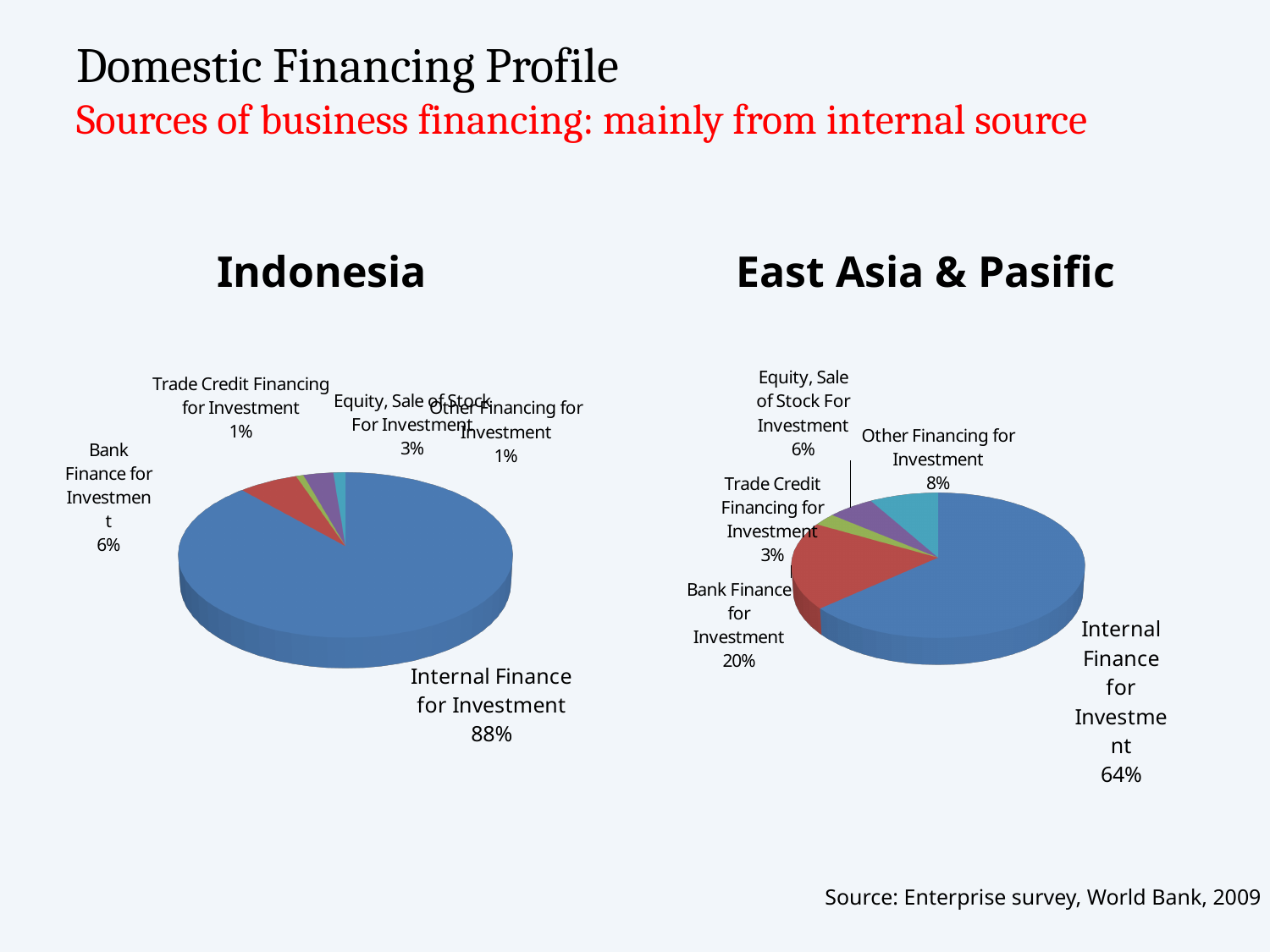
In the East Asia & Pasific chart, what share does Other Financing for Investment have? 8% In the East Asia & Pasific chart, what is the difference between Bank Finance for Investment and Equity, Sale of Stock For Investment? 14 percentage points What is the difference between the Internal Finance for Investment share in the Indonesia chart and in the East Asia & Pasific chart? 24 percentage points In the Indonesia chart, what share does Bank Finance for Investment have? 6% In the Indonesia chart, which category has the largest share? Internal Finance for Investment In the Indonesia chart, what share does Internal Finance for Investment have? 88% What kind of chart is the Indonesia chart? Pie chart How many categories are shown in the Indonesia pie chart? 5 In the East Asia & Pasific chart, which category has the smallest share? Trade Credit Financing for Investment Which chart shows a larger share for Bank Finance for Investment, Indonesia or East Asia & Pasific? East Asia & Pasific In the East Asia & Pasific chart, which category has the largest share? Internal Finance for Investment In the East Asia & Pasific chart, what share does Bank Finance for Investment have? 20%